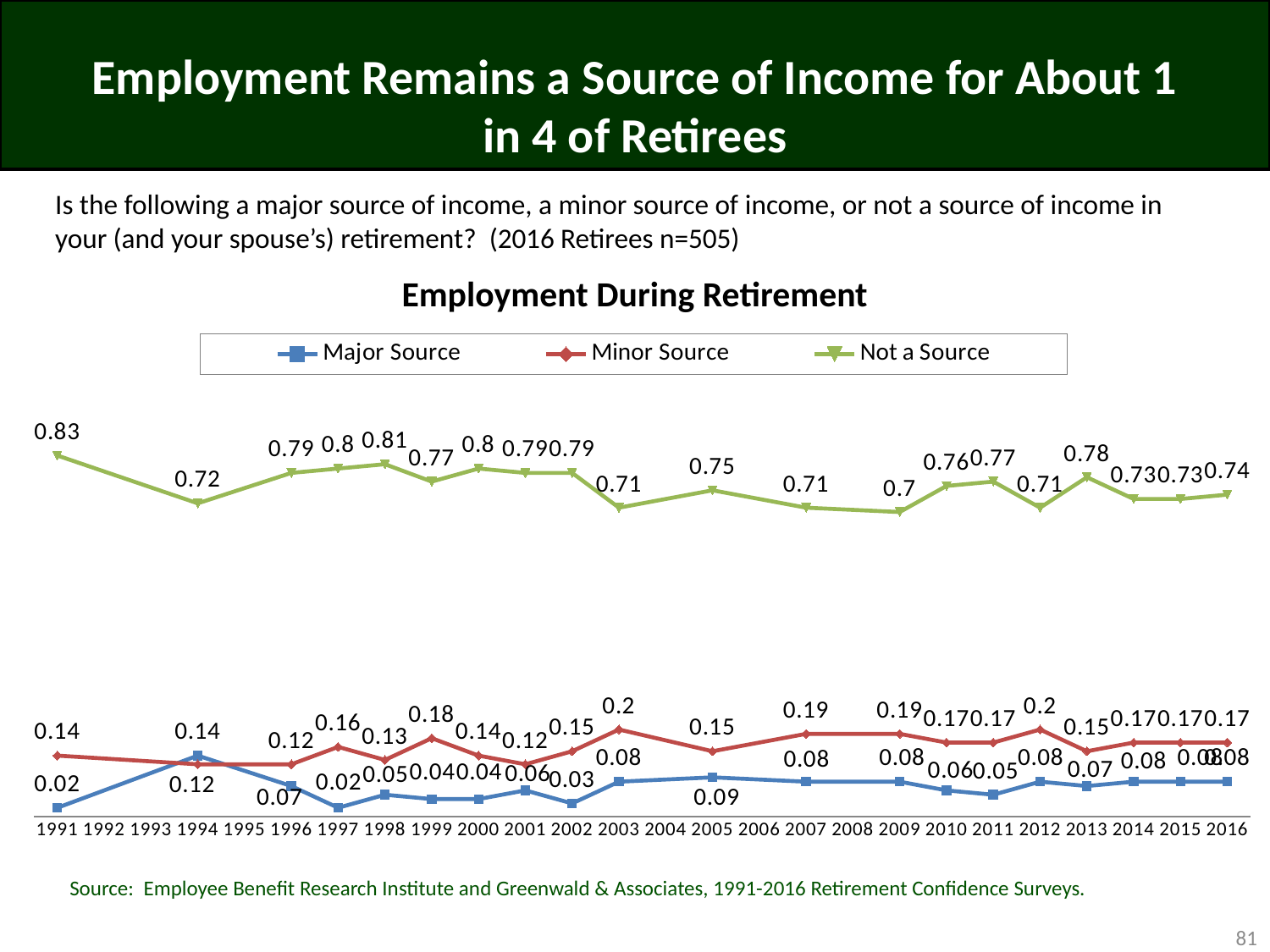
In which year is the Major Source value highest? 1994 Which is larger in 1999: the Minor Source value or the Major Source value? Minor Source What is the value for Not a Source in 1991? 0.83 In which year is the Not a Source value highest? 1991 In which year is the Not a Source value lowest? 2009 What is the difference between the Not a Source values in 1991 and 2016? 0.09 What is the value for Minor Source in 2003? 0.2 How many series does the legend list? 3 What is the title of the chart? Employment During Retirement What is the value for Major Source in 1994? 0.14 What type of chart is shown on the slide? line chart What is the value for Not a Source in 2016? 0.74